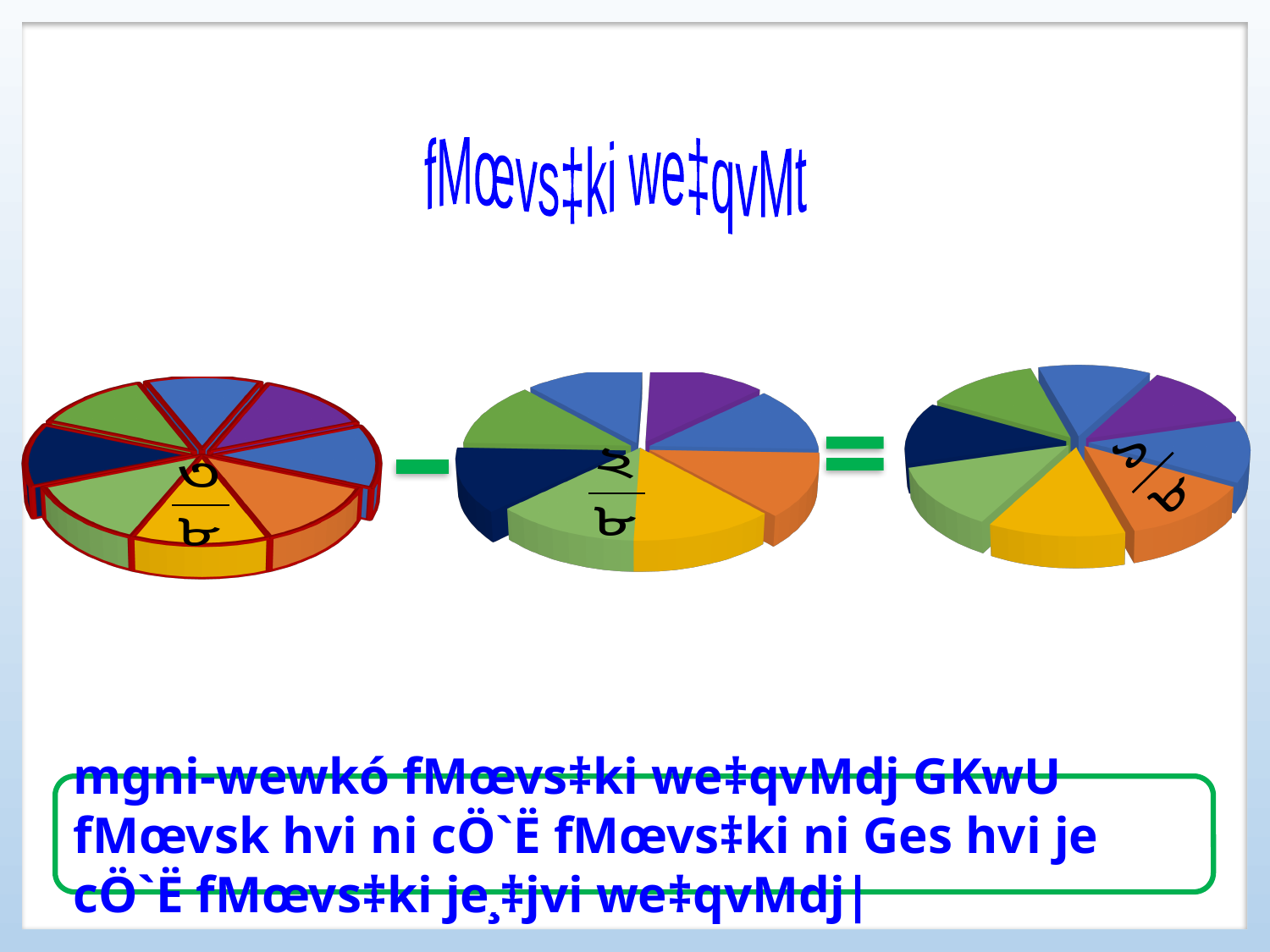
How many slices does the right pie chart have? 8 How many pie charts are shown on the slide? 3 What fraction is printed on the right pie chart? ১/৮ What kind of chart is used on this slide? pie chart How many slices does the middle pie chart have? 8 What fraction is printed on the left pie chart? ৩/৮ What operator symbol appears between the left and middle pie charts? minus sign (−) How many slices does the left pie chart have? 8 What fraction is printed on the middle pie chart? ২/৮